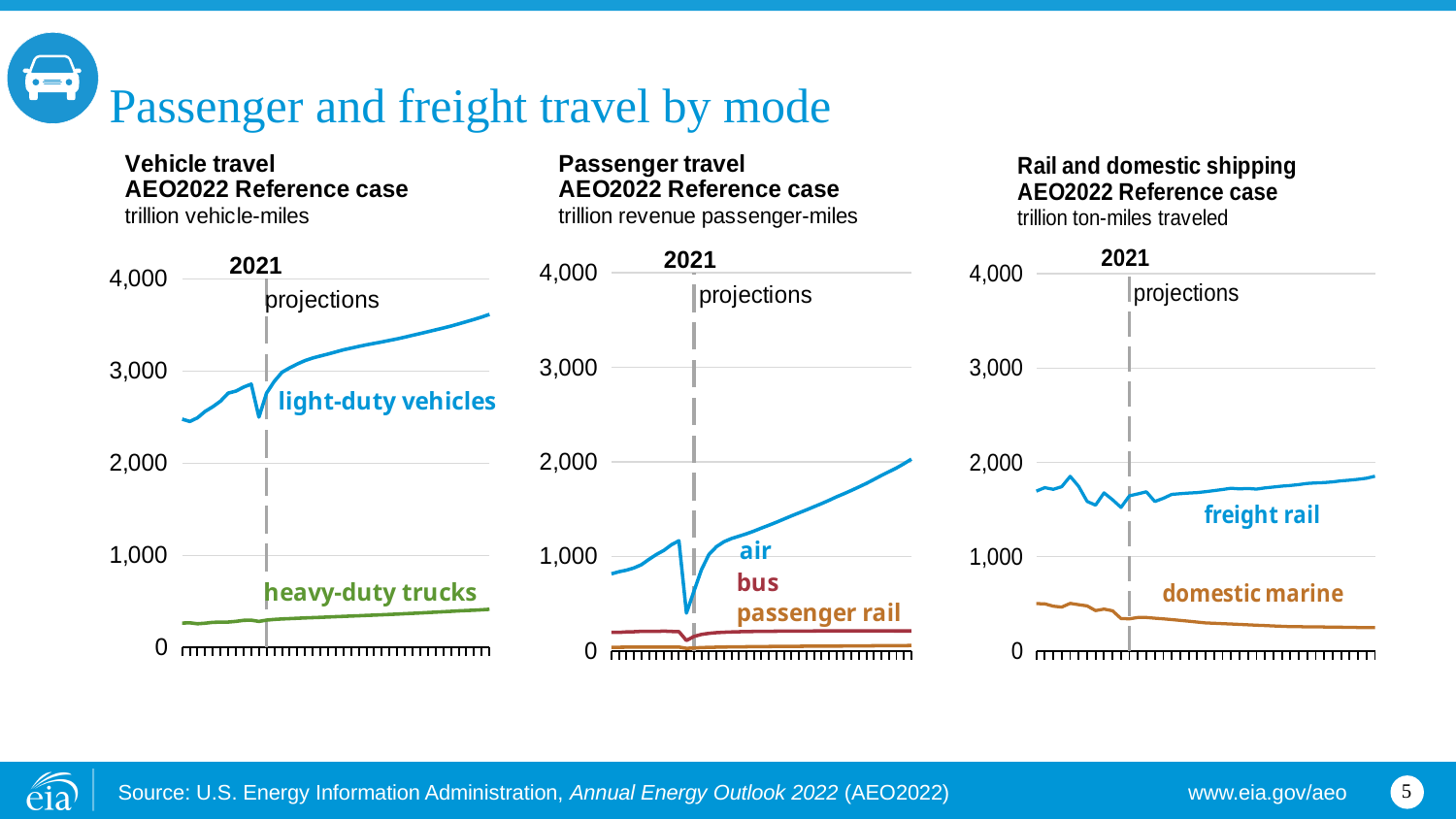
In the Passenger travel chart, which series has the highest values? air In the Vehicle travel chart, what kind of chart is shown? line chart In the Rail and domestic shipping chart, do domestic marine ton-miles rise or fall over the projection period? fall What unit is used on the Passenger travel chart? trillion revenue passenger-miles In the Passenger travel chart, how many series are plotted? 3 In the Vehicle travel chart, is the value for heavy-duty trucks in 2021 greater or less than 1,000? less In the Vehicle travel chart, which series has higher values, light-duty vehicles or heavy-duty trucks? light-duty vehicles In the Rail and domestic shipping chart, which series has the lowest values? domestic marine In the Vehicle travel chart, how many series are plotted? 2 In the Vehicle travel chart, do light-duty vehicle-miles rise or fall over the projection period? rise In the Vehicle travel chart, is the value for light-duty vehicles at the end of the projection period greater or less than 3,000? greater